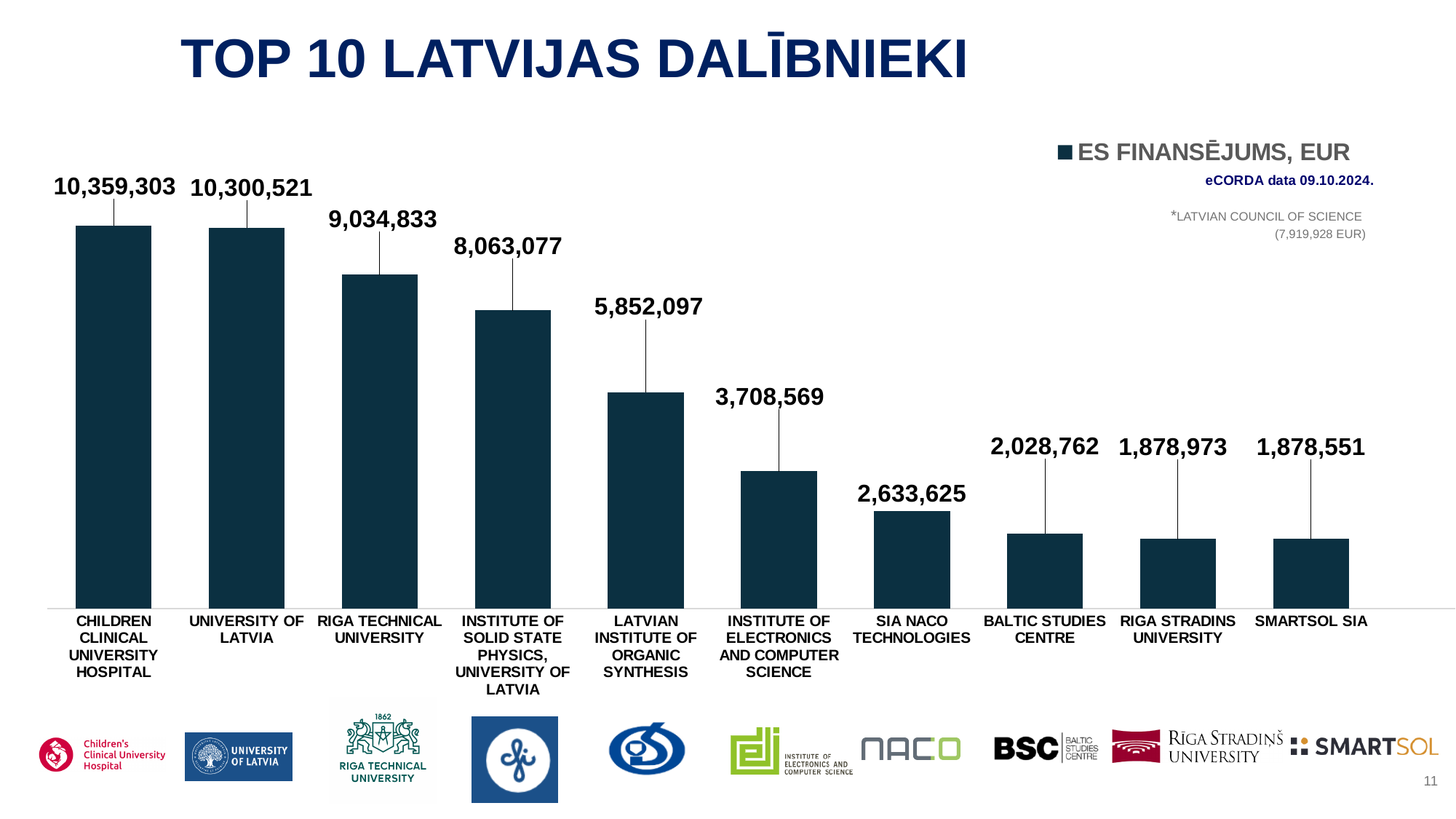
What kind of chart is shown on the slide? bar chart Which is larger, the value for Institute of Electronics and Computer Science or the value for Baltic Studies Centre? Institute of Electronics and Computer Science Do the values rise or fall from left to right along the x axis? fall What is the difference between the values for Riga Technical University and Institute of Solid State Physics, University of Latvia? 971,756 What is the value for University of Latvia? 10,300,521 Which category has the highest value? Children Clinical University Hospital What is the difference between the values for Children Clinical University Hospital and University of Latvia? 58,782 How many series does the legend list? 1 What is the value for SIA NACO Technologies? 2,633,625 What is the value for Latvian Institute of Organic Synthesis? 5,852,097 How many categories are shown in the chart? 10 Which category has the lowest value? SmartSol SIA